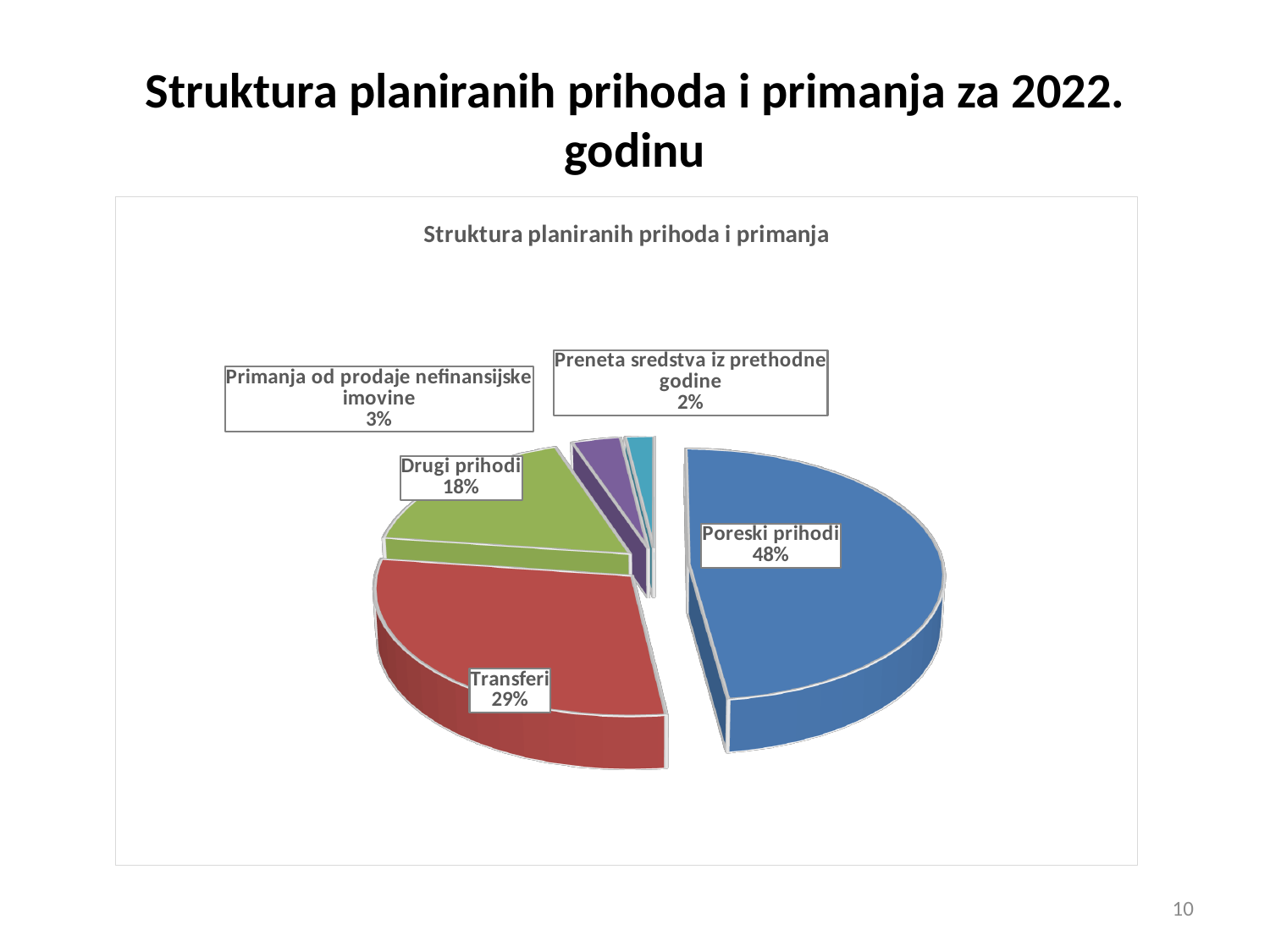
What share of the pie does Transferi represent? 29% What share of the pie does Drugi prihodi represent? 18% What is the title of the chart? Struktura planiranih prihoda i primanja Which is larger, the share for Drugi prihodi or the share for Transferi? Transferi What share of the pie does Poreski prihodi represent? 48% What kind of chart is shown on the slide? Pie chart How many categories are shown in the pie chart? 5 What is the difference in percentage points between Poreski prihodi and Transferi? 19 Which category has the largest share of the pie? Poreski prihodi Which category has the smallest share of the pie? Preneta sredstva iz prethodne godine